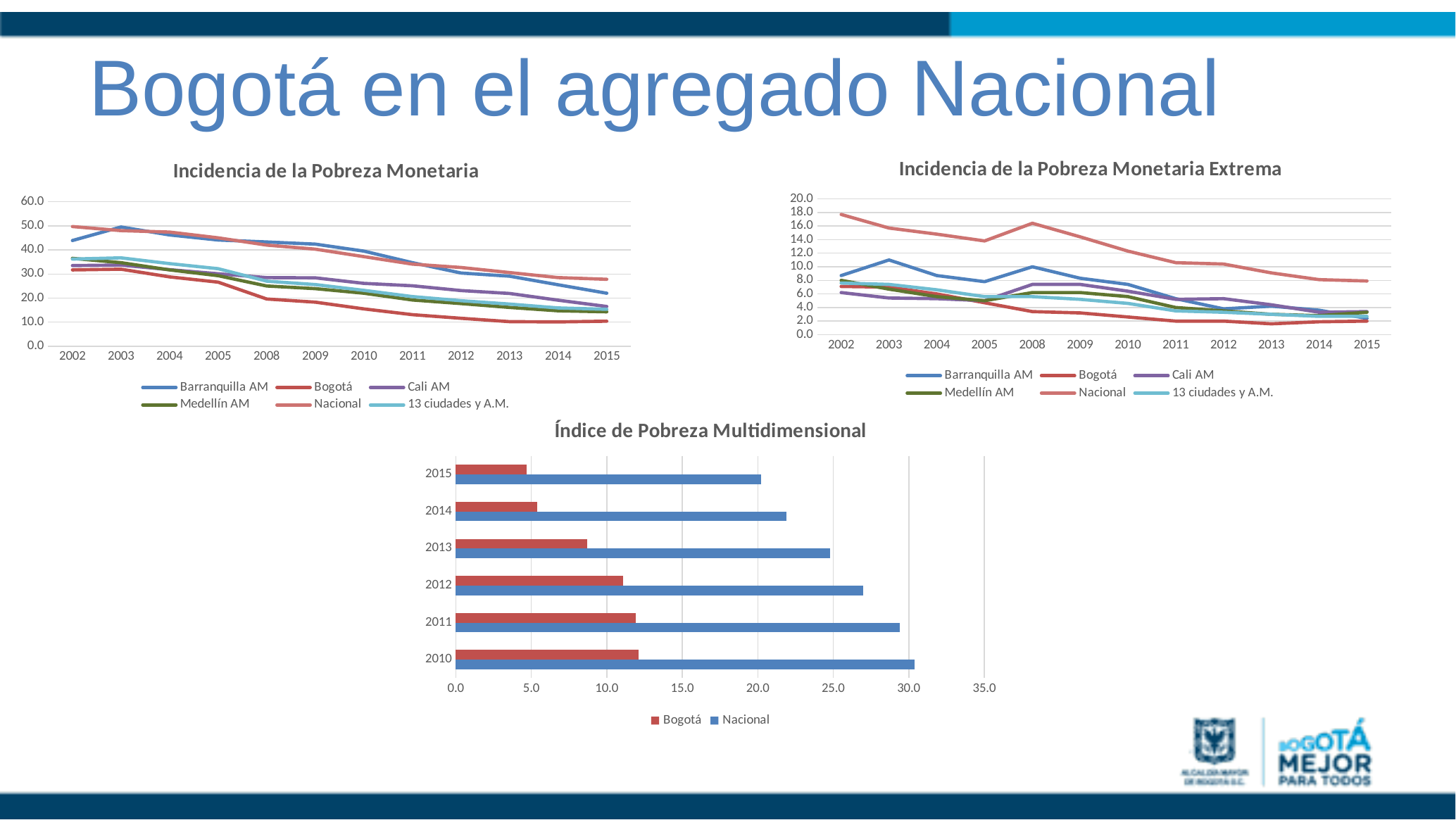
In the "Índice de Pobreza Multidimensional" chart, is the value for Nacional in 2010 greater or less than 25? greater In the "Incidencia de la Pobreza Monetaria Extrema" chart, is the value for Nacional in 2002 greater or less than 16? greater How many series does the legend of the "Incidencia de la Pobreza Monetaria Extrema" chart list? 6 What kind of chart is the "Incidencia de la Pobreza Monetaria" chart? line chart How many years are shown on the x axis of the "Incidencia de la Pobreza Monetaria" chart? 12 In the "Índice de Pobreza Multidimensional" chart, which is larger in 2012, Bogotá or Nacional? Nacional How many years are shown in the "Índice de Pobreza Multidimensional" chart? 6 What kind of chart is the "Índice de Pobreza Multidimensional" chart? bar chart In the "Incidencia de la Pobreza Monetaria" chart, which series has the lowest value in 2015? Bogotá In the "Índice de Pobreza Multidimensional" chart, do the Nacional values rise or fall from 2010 to 2015? fall In the "Incidencia de la Pobreza Monetaria" chart, is the value for Barranquilla AM in 2002 greater or less than 40? greater In the "Incidencia de la Pobreza Monetaria Extrema" chart, which series has the highest value in 2002? Nacional